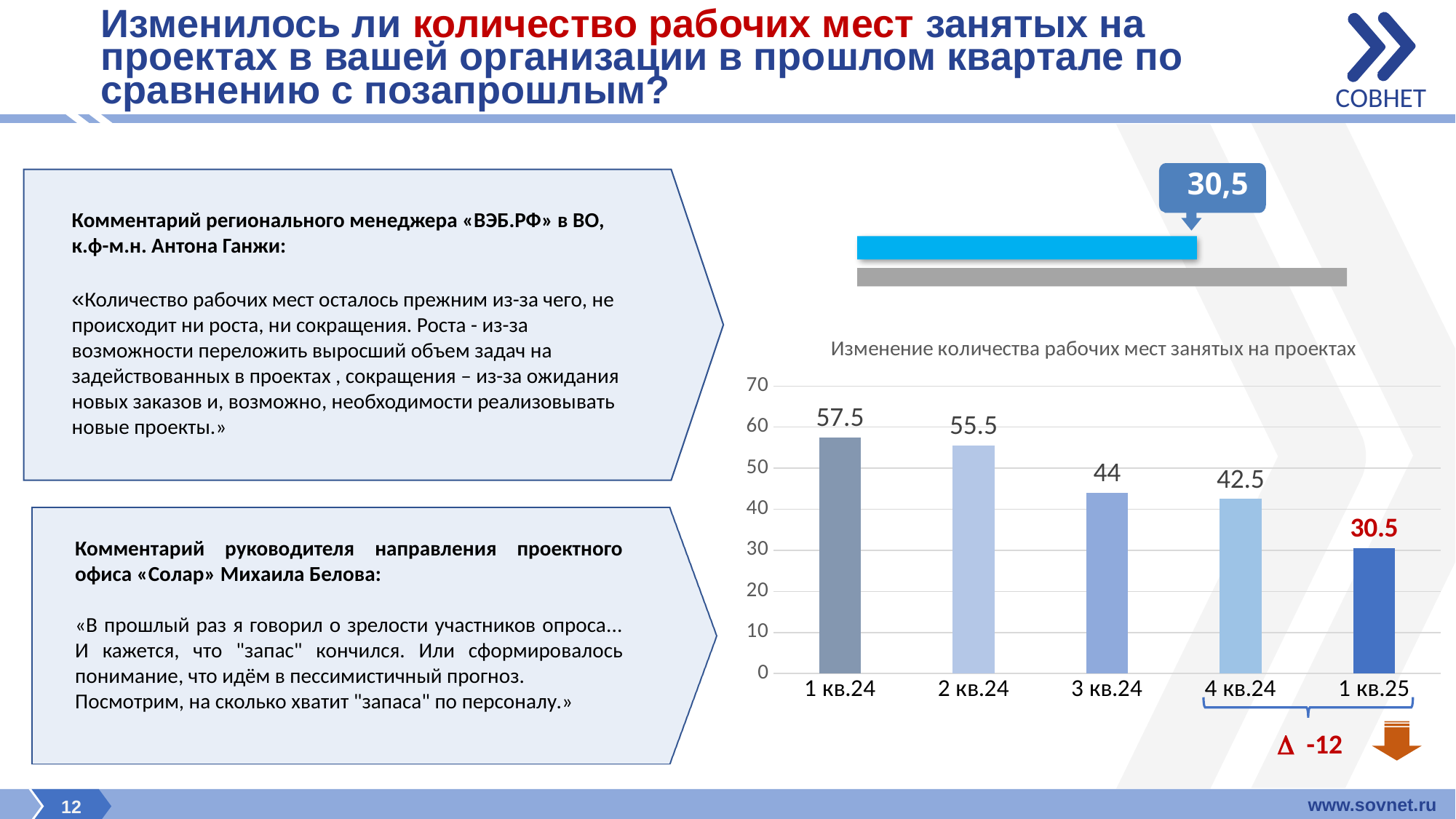
Which quarter has the lowest value in the bar chart? 1 кв.25 Do the values rise or fall from 1 кв.24 to 1 кв.25? fall How many quarters are shown on the x axis of the bar chart? 5 What is the value for 3 кв.24 in the bar chart? 44 What is the difference between the values for 4 кв.24 and 1 кв.25? 12 Is the value for 4 кв.24 greater or less than 50? less Which quarter has the highest value in the bar chart? 1 кв.24 What kind of chart is used to show the change in the number of project jobs? bar chart What is the value for 1 кв.25 in the bar chart? 30.5 What is the value for 1 кв.24 in the bar chart? 57.5 What is the difference between the values for 1 кв.24 and 2 кв.24? 2 Which is larger, the value for 2 кв.24 or the value for 3 кв.24? 2 кв.24